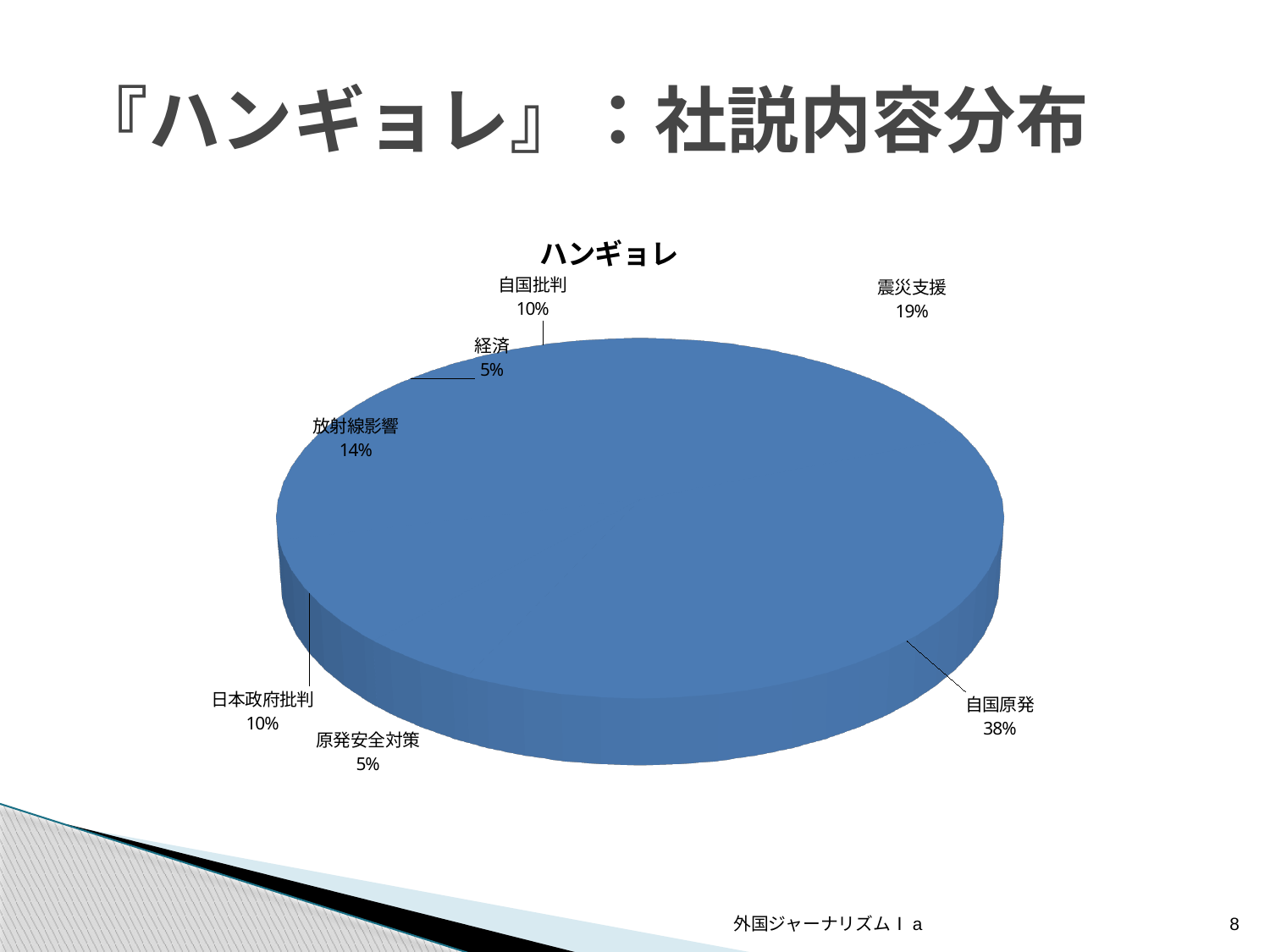
What is the difference between the shares of 震災支援 and 原発安全対策? 14% What is the value shown for 放射線影響? 14% What is the title of the chart? ハンギョレ What is the difference between the shares of 自国原発 and 震災支援? 19% Which category has the largest share of the pie? 自国原発 How many categories are shown in the pie chart? 7 What kind of chart is shown on the slide? pie chart Which is larger, the share for 放射線影響 or the share for 自国批判? 放射線影響 What is the value shown for 震災支援? 19% What share of the pie does 自国原発 account for? 38% What is the value shown for 経済? 5% What is the value shown for 日本政府批判? 10%